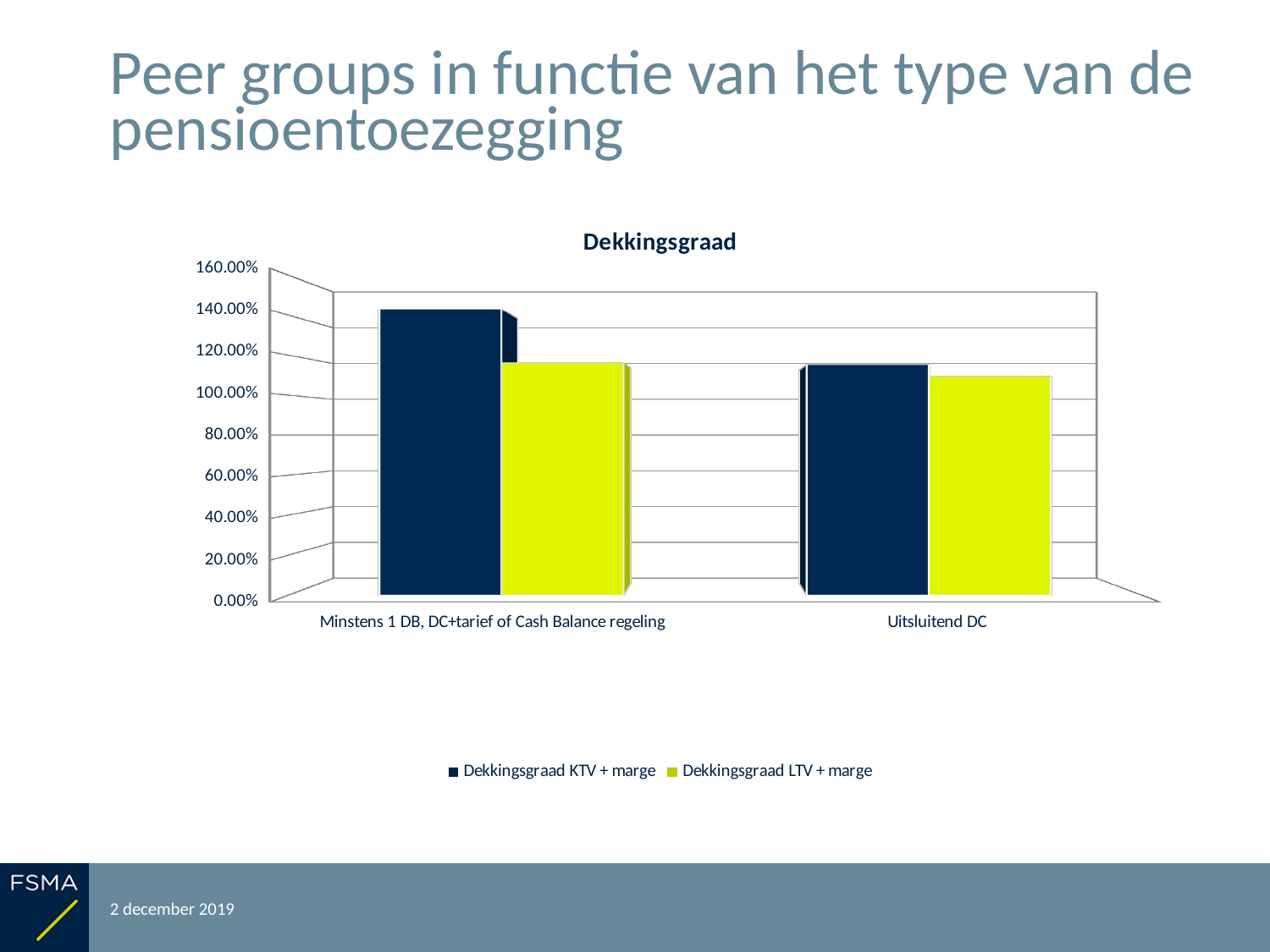
For the series Dekkingsgraad KTV + marge, which category has the larger value? Minstens 1 DB, DC+tarief of Cash Balance regeling Which series is shown in yellow-green? Dekkingsgraad LTV + marge Is the value for Dekkingsgraad LTV + marge in the category 'Minstens 1 DB, DC+tarief of Cash Balance regeling' greater or less than 100.00%? greater Is the value for Dekkingsgraad KTV + marge in the category 'Uitsluitend DC' greater or less than 140.00%? less How many series does the legend list? 2 What kind of chart is shown on the slide? bar chart What is the title of the chart? Dekkingsgraad Is the value for Dekkingsgraad KTV + marge in the category 'Minstens 1 DB, DC+tarief of Cash Balance regeling' greater or less than 120.00%? greater How many categories are shown on the x axis? 2 In the category 'Minstens 1 DB, DC+tarief of Cash Balance regeling', which series has the larger value, Dekkingsgraad KTV + marge or Dekkingsgraad LTV + marge? Dekkingsgraad KTV + marge Which bar is the highest in the chart? Dekkingsgraad KTV + marge for Minstens 1 DB, DC+tarief of Cash Balance regeling